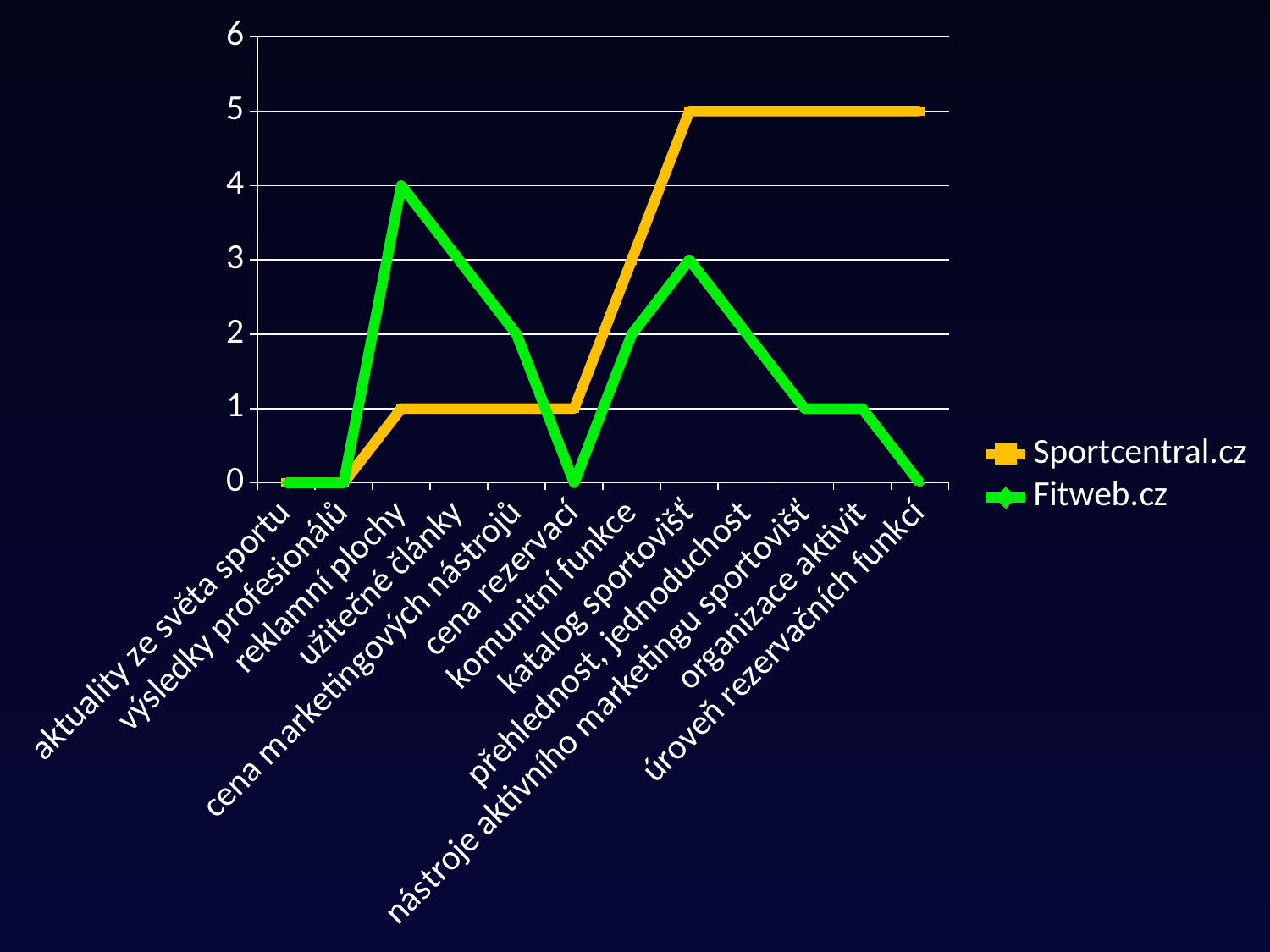
What is the value for Sportcentral.cz at cena marketingových nástrojů? 1 Does the Sportcentral.cz line rise or fall between cena rezervací and katalog sportovišť? rise What is the value for Fitweb.cz at cena rezervací? 0 What is the value for Sportcentral.cz at katalog sportovišť? 5 What is the value for Fitweb.cz at reklamní plochy? 4 How many series does the legend list? 2 At which category does Fitweb.cz reach its highest value? reklamní plochy Which series has the larger value at organizace aktivit? Sportcentral.cz How many categories are plotted along the x axis? 12 What colour is the Fitweb.cz line? green What is the difference between Fitweb.cz and Sportcentral.cz at reklamní plochy? 3 What kind of chart is shown on the slide? line chart